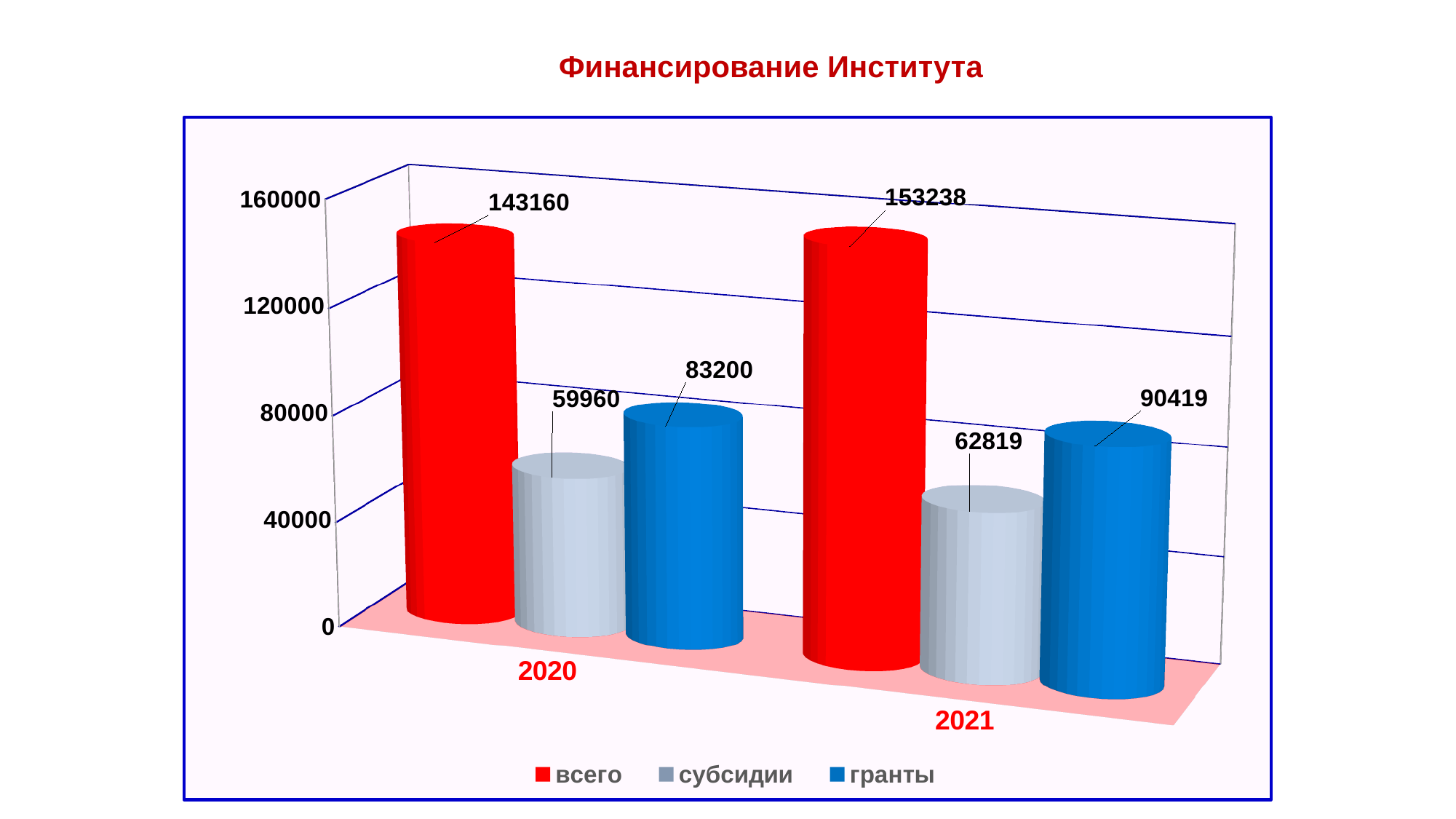
What is the value for всего in 2020? 143160 Which year has the higher value for всего? 2021 What is the value for гранты in 2021? 90419 How many series does the legend list? 3 What is the value for субсидии in 2020? 59960 Which series has the lowest value in 2021? субсидии What is the difference between гранты and субсидии in 2020? 23240 What is the difference between всего in 2021 and всего in 2020? 10078 Which is larger: гранты in 2020 or гранты in 2021? гранты in 2021 What is the value for субсидии in 2021? 62819 What is the title of the chart? Финансирование Института What kind of chart is shown? bar chart